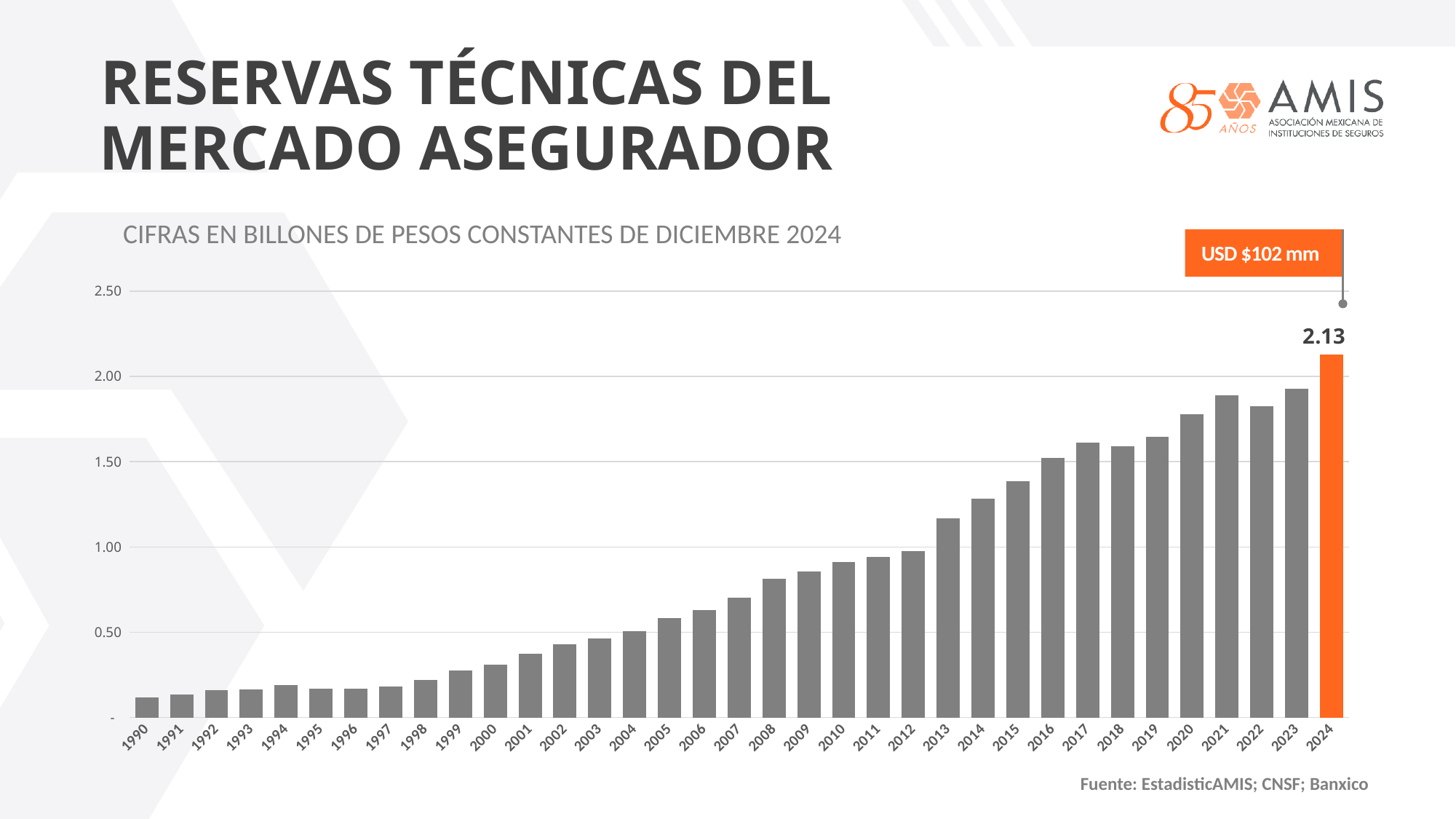
How many years (bars) are shown in the chart? 35 Do the values generally rise or fall from 1990 to 2024? Rise What kind of chart is shown on the slide? Bar chart Which year has the highest value in the chart? 2024 Which is larger, the value for 2021 or the value for 2018? 2021 Is the value for 2010 greater or less than 1.00? less Is the value for 2013 greater or less than 1.00? greater Is the value for 2023 greater or less than 1.50? greater What is the value shown for 2024? 2.13 What USD amount is shown in the callout above the 2024 bar? USD $102 mm Which year has the lowest value in the chart? 1990